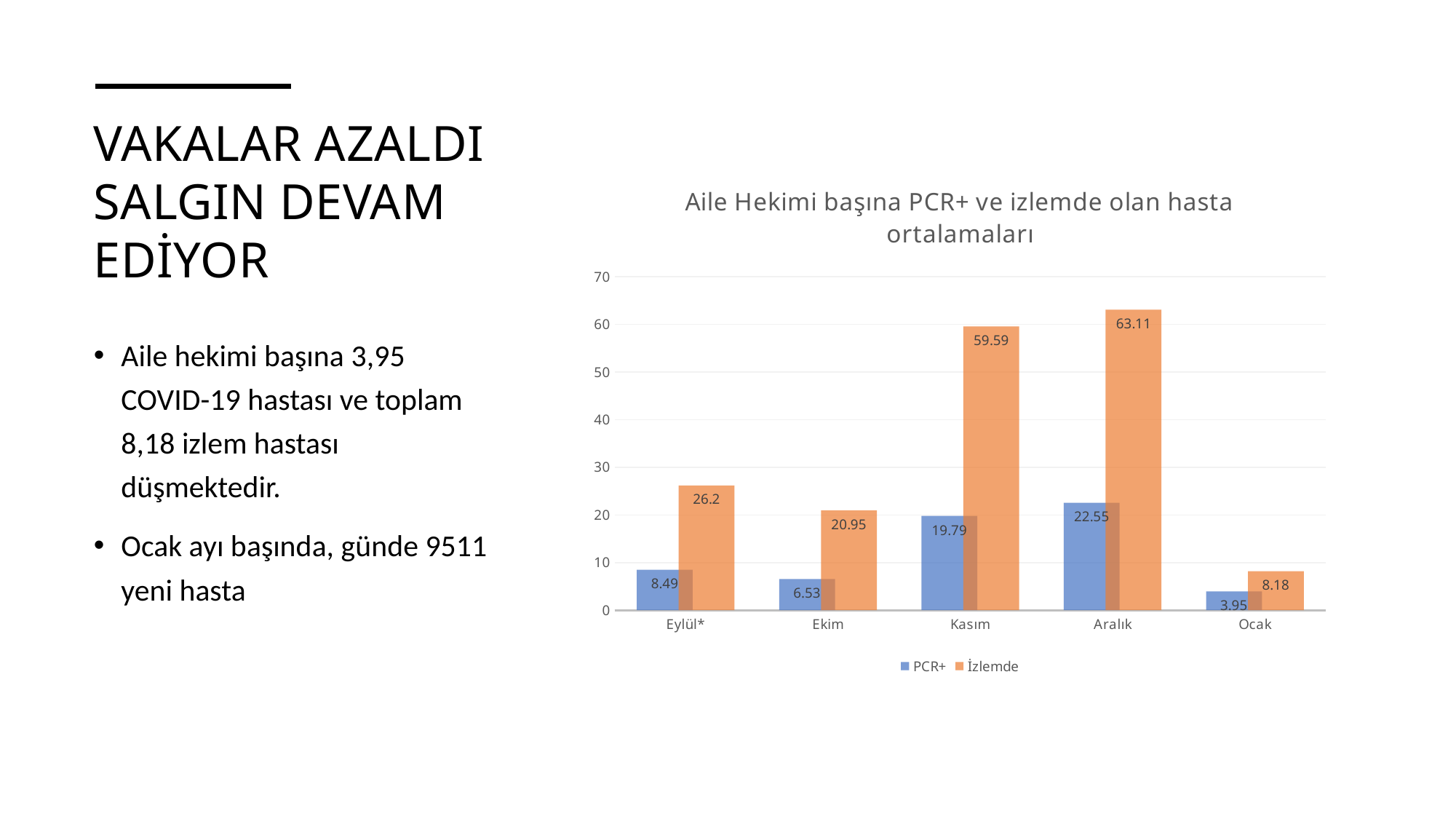
How many months are shown on the x axis? 5 What is the PCR+ value for Ocak? 3.95 Which month has the lowest PCR+ value? Ocak Which is larger, the PCR+ value for Ekim or the PCR+ value for Eylül*? Eylül* What is the title of the chart? Aile Hekimi başına PCR+ ve izlemde olan hasta ortalamaları What is the İzlemde value for Eylül*? 26.2 What is the difference between the İzlemde and PCR+ values for Kasım? 39.8 What kind of chart is shown on the slide? Bar chart How many series does the legend list? 2 What is the PCR+ value for Kasım? 19.79 Which month has the highest İzlemde value? Aralık What is the İzlemde value for Aralık? 63.11